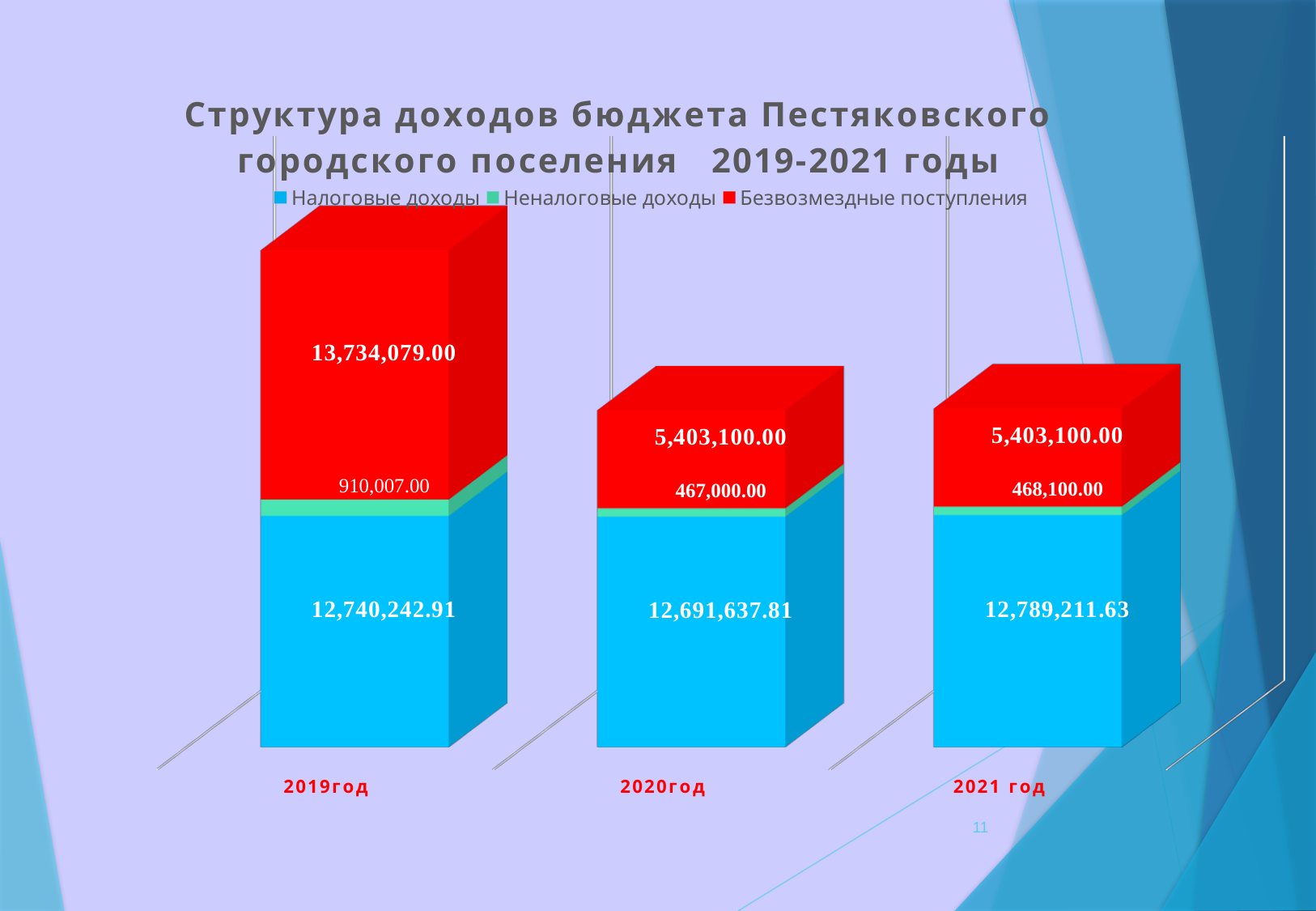
What is the value of Налоговые доходы for 2021 год? 12,789,211.63 How many series does the legend list? 3 What is the total of the stacked bar for 2020год? 18,561,737.81 Which is larger: Налоговые доходы in 2021 год or in 2020год? 2021 год How many years (categories) are shown on the x axis? 3 In which year is Безвозмездные поступления the highest? 2019год What is the difference between Безвозмездные поступления in 2019год and in 2020год? 8,330,979.00 What is the value of Неналоговые доходы for 2020год? 467,000.00 What kind of chart is shown on the slide? Stacked bar chart Which colour represents Налоговые доходы in the legend? Blue What is the value of Безвозмездные поступления for 2019год? 13,734,079.00 In which year is Неналоговые доходы the lowest? 2020год